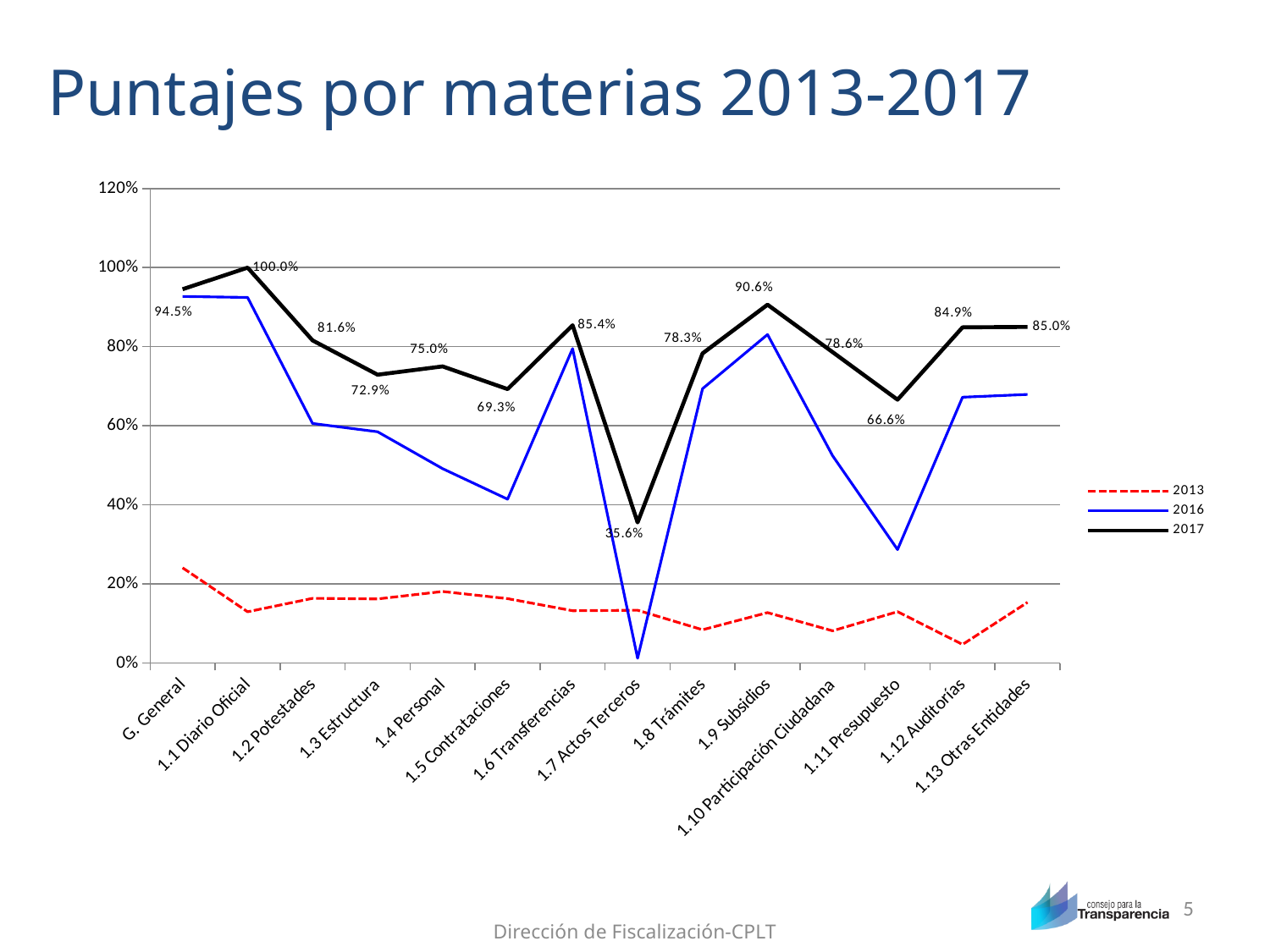
How many categories are shown on the x axis? 14 Which category has the highest 2017 value? 1.1 Diario Oficial What is the 2017 value for 1.7 Actos Terceros? 35.6% Is the 2013 value for G. General greater or less than 40%? less How many series does the legend list? 3 What is the difference between the 2017 values for 1.9 Subsidios and 1.11 Presupuesto? 24.0 percentage points Which category has the lowest 2017 value? 1.7 Actos Terceros What is the 2017 value for 1.1 Diario Oficial? 100.0% Is the 2016 value for 1.7 Actos Terceros greater or less than 20%? less Which has the larger 2017 value, 1.2 Potestades or 1.4 Personal? 1.2 Potestades What kind of chart is shown on the slide? Line chart What is the 2017 value for 1.13 Otras Entidades? 85.0%